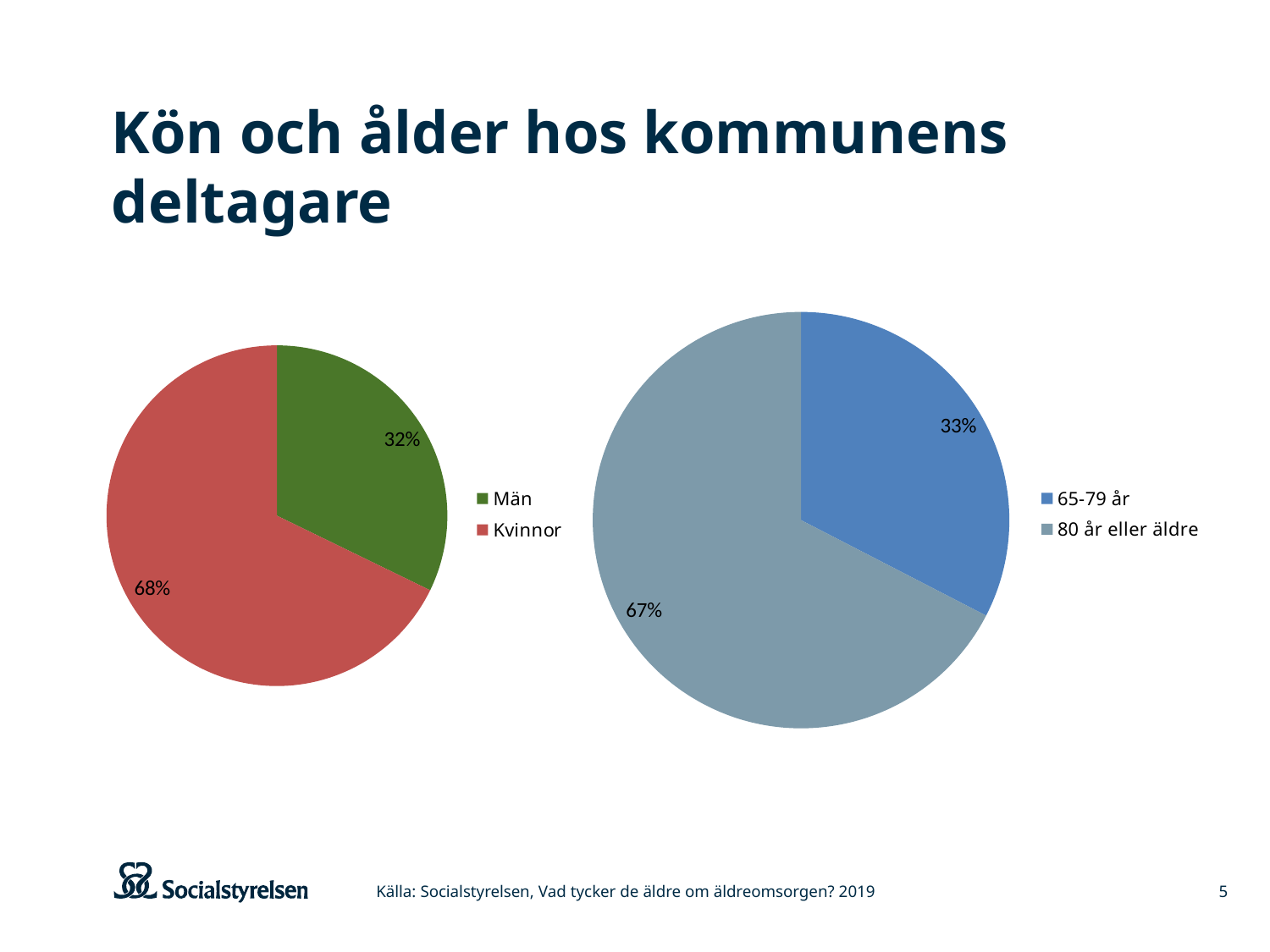
In the left pie chart (gender), what share of participants are Kvinnor? 68% In the right pie chart (age), what is the difference in percentage points between 80 år eller äldre and 65-79 år? 34 percentage points What colour is the Kvinnor slice in the left pie chart? Red In the right pie chart (age), what share of participants are 65-79 år? 33% In the left pie chart (gender), what share of participants are Män? 32% In the left pie chart (gender), which category has the largest share? Kvinnor In the right pie chart (age), what share of participants are 80 år eller äldre? 67% How many categories does the legend of the right pie chart (age) list? 2 In the right pie chart (age), which category has the smallest share? 65-79 år Is the share of Män in the left pie chart larger or smaller than the share of 65-79 år in the right pie chart? smaller What type of chart is used on the left of the slide? Pie chart In the left pie chart (gender), what is the difference in percentage points between Kvinnor and Män? 36 percentage points